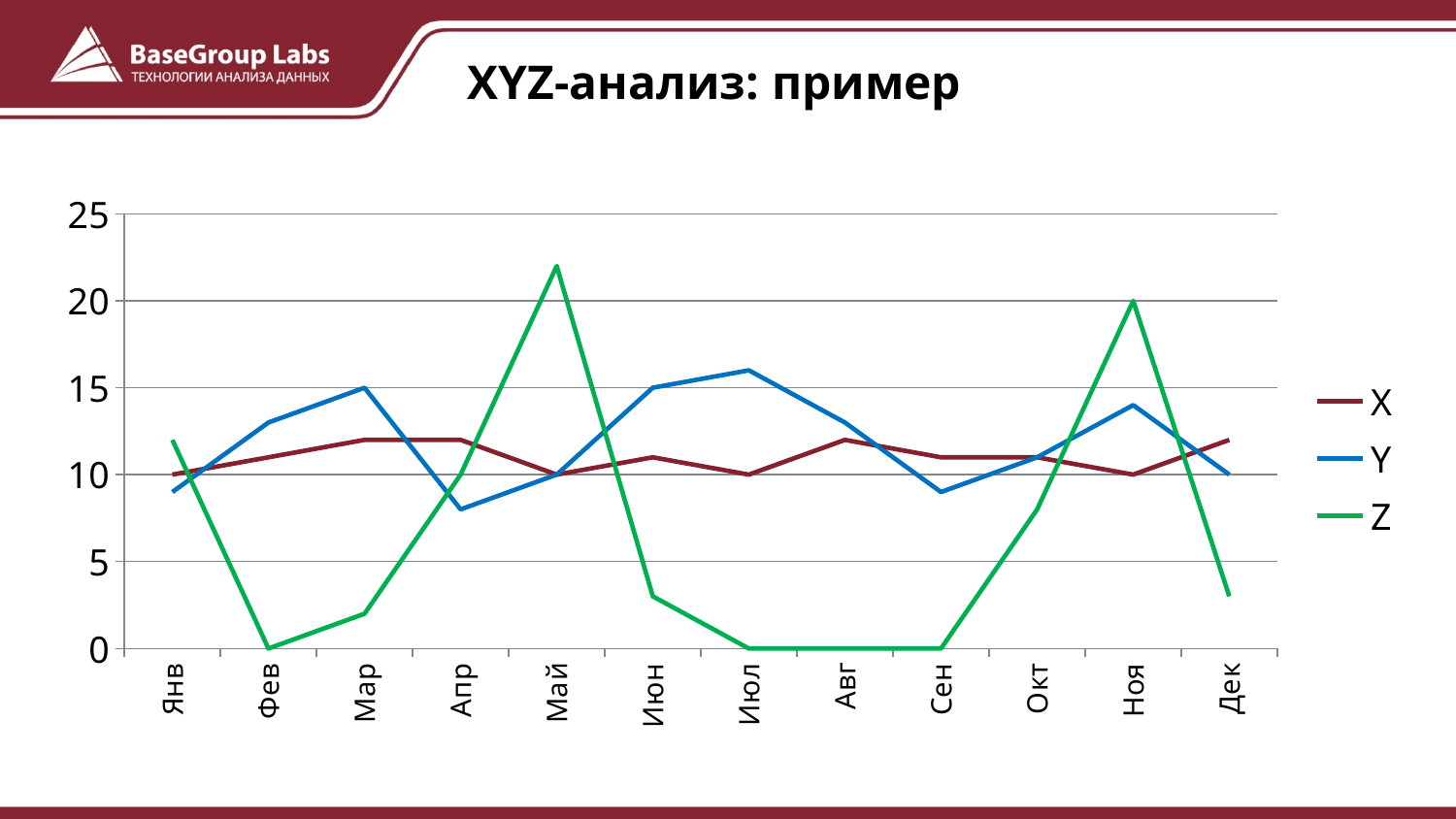
How many series does the legend list? 3 What kind of chart is shown on the slide? line chart How many months are shown on the x axis? 12 In which month does series Z reach its highest value? Май What is the title of the slide containing the chart? XYZ-анализ: пример Which series has the higher value in Май, Y or Z? Z What is the value of series Z in Фев? 0 Is the value of series Y in Апр greater or less than 10? less Which series has the higher value in Мар, X or Y? Y Is the value of series Z in Май greater or less than 20? greater What is the value of series Z in Ноя? 20 What is the value of series Y in Мар? 15